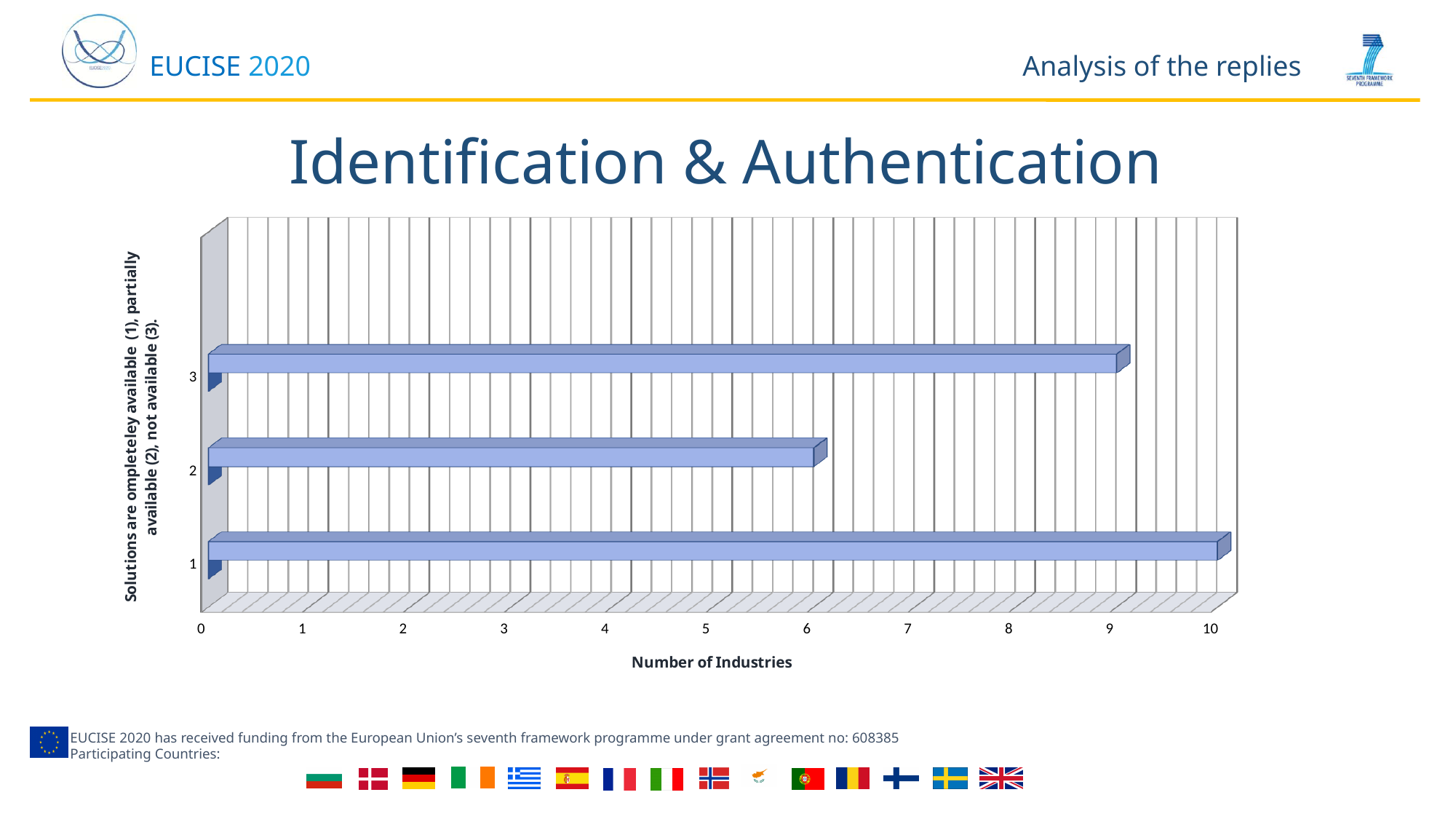
Which category has the lowest number of industries? 2 How many categories (bars) does the chart show? 3 Is the value for category 2 greater or less than 4? greater Is the value for category 2 greater or less than 8? less Is the value for category 1 greater or less than 8? greater Which category has the highest number of industries? 1 What is the title of the chart on the slide? Identification & Authentication What kind of chart is shown on the slide? bar chart Which category has a larger value, 2 or 3? 3 Which category has a larger value, 1 or 3? 1 What is the title of the horizontal axis? Number of Industries